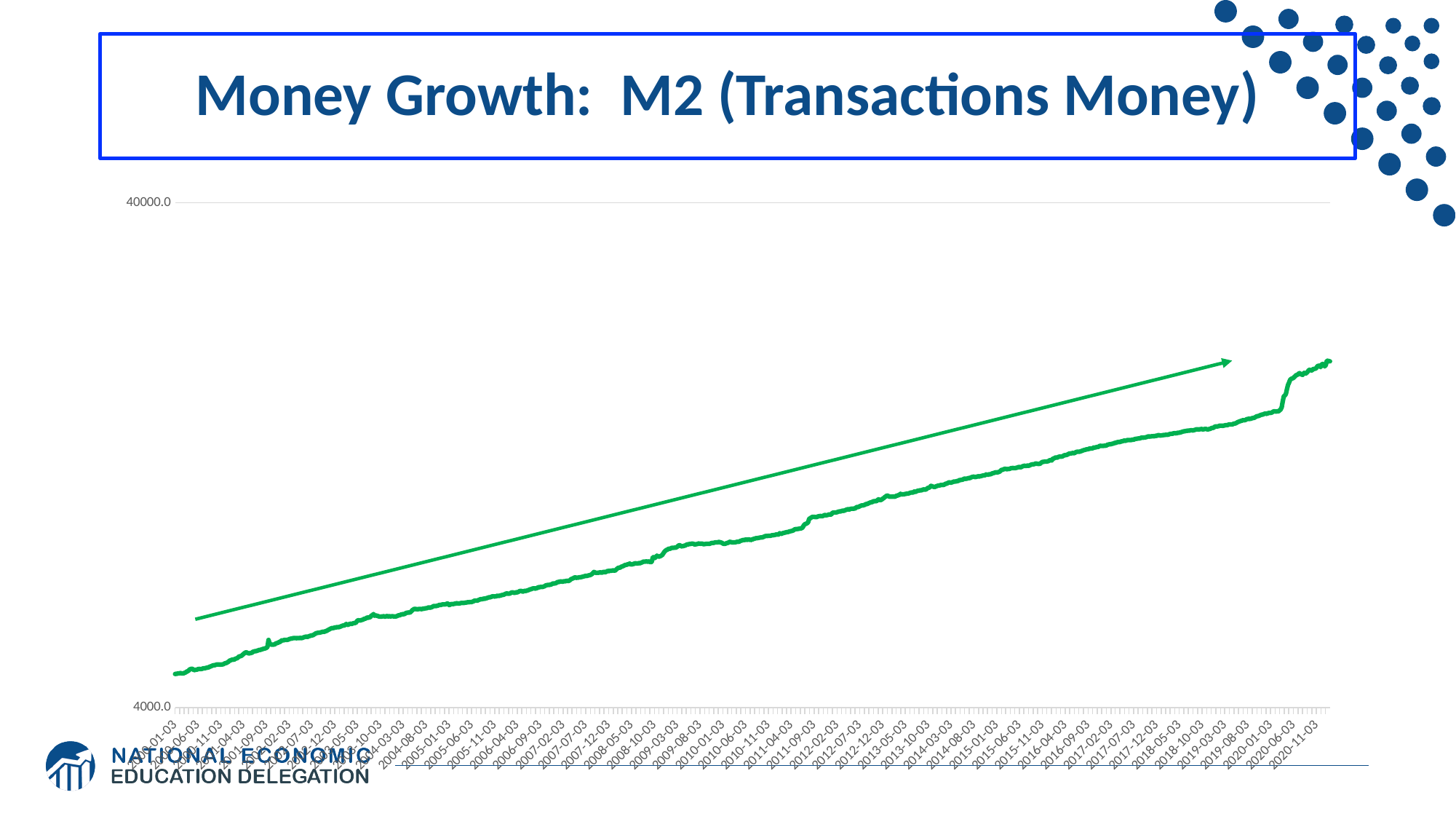
Is the value of the line at 2020-11-03 greater or less than 4000.0? greater What is the title of the slide containing the chart? Money Growth: M2 (Transactions Money) Is the value of the line at 2020-11-03 greater or less than 40000.0? less Which is larger, the value of the line at 2010-01-03 or at 2020-01-03? 2020-01-03 Which is larger, the value of the line at 2000-06-03 or at 2005-01-03? 2005-01-03 What is the highest value label shown on the y axis? 40000.0 Do the plotted values generally rise or fall from 2000 to 2020 along the x axis? rise What colour is the plotted line on the chart? green Is the value of the line at 2000-01-03 greater or less than 40000.0? less What kind of chart is shown on the slide? line chart